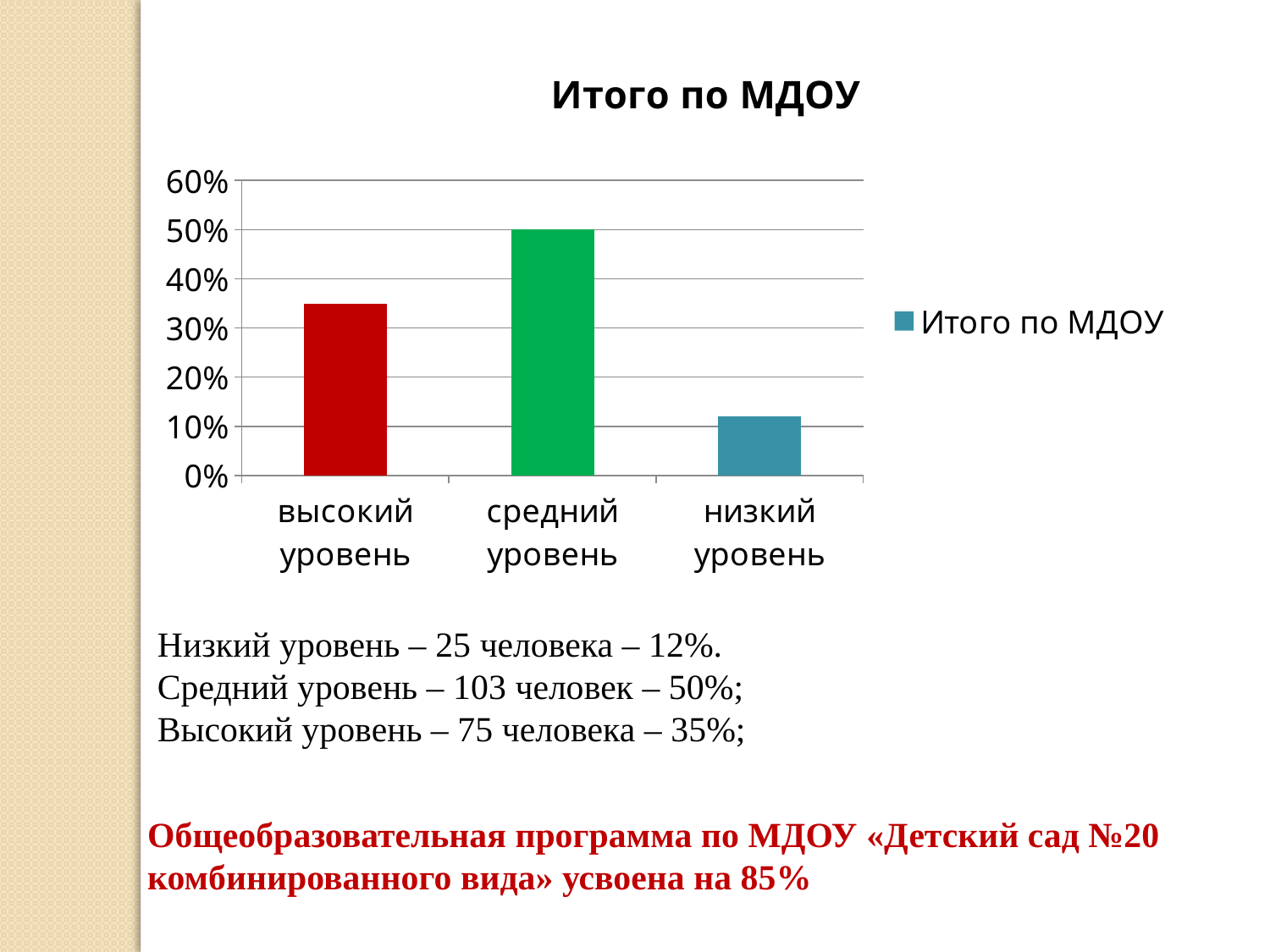
What is the value for высокий уровень? 35% Which is larger, the value for высокий уровень or the value for низкий уровень? высокий уровень What is the title of the chart? Итого по МДОУ How many categories are shown on the x axis of the chart? 3 What is the value for низкий уровень? 12% Which category has the lowest value in the chart? низкий уровень Is the value for высокий уровень greater or less than 30%? greater Which category has the highest value in the chart? средний уровень How many series does the legend list? 1 What is the value for средний уровень? 50% Is the value for низкий уровень greater or less than 20%? less What kind of chart is shown on the slide? bar chart